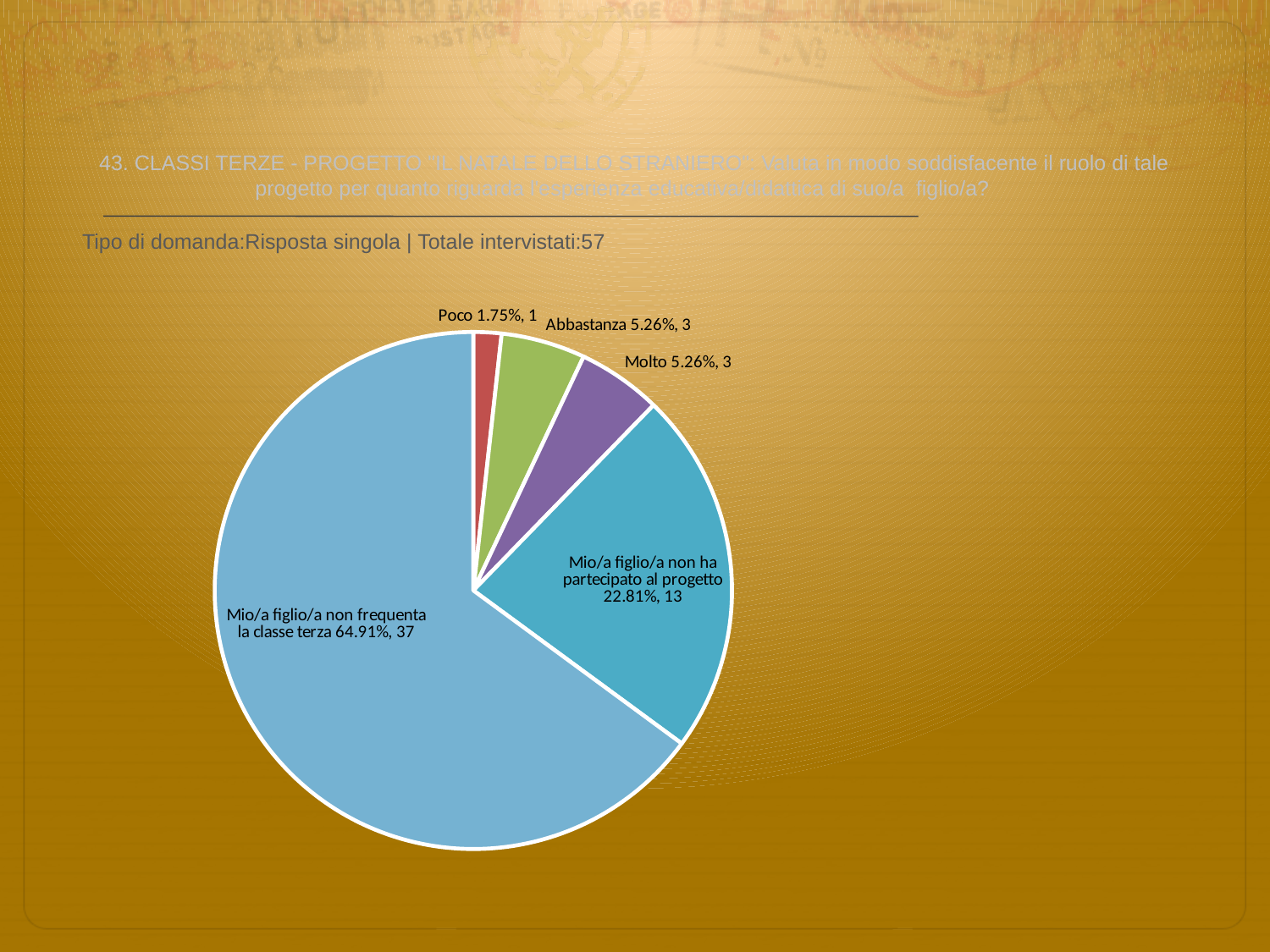
What is the percentage share of the "Molto" slice? 5.26% What is the count shown for "Abbastanza"? 3 What percentage share does the slice "Mio/a figlio/a non frequenta la classe terza" have? 64.91% Which slice is the largest in the pie chart? Mio/a figlio/a non frequenta la classe terza What is the total number of respondents (Totale intervistati) stated on the slide? 57 What is the count shown for "Mio/a figlio/a non ha partecipato al progetto"? 13 What is the difference in count between "Mio/a figlio/a non frequenta la classe terza" and "Mio/a figlio/a non ha partecipato al progetto"? 24 How many slices does the pie chart have? 5 What percentage share does the "Poco" slice have? 1.75% Which slice is the smallest in the pie chart? Poco What kind of chart is shown on the slide? pie chart Which has a larger count, "Molto" or "Poco"? Molto